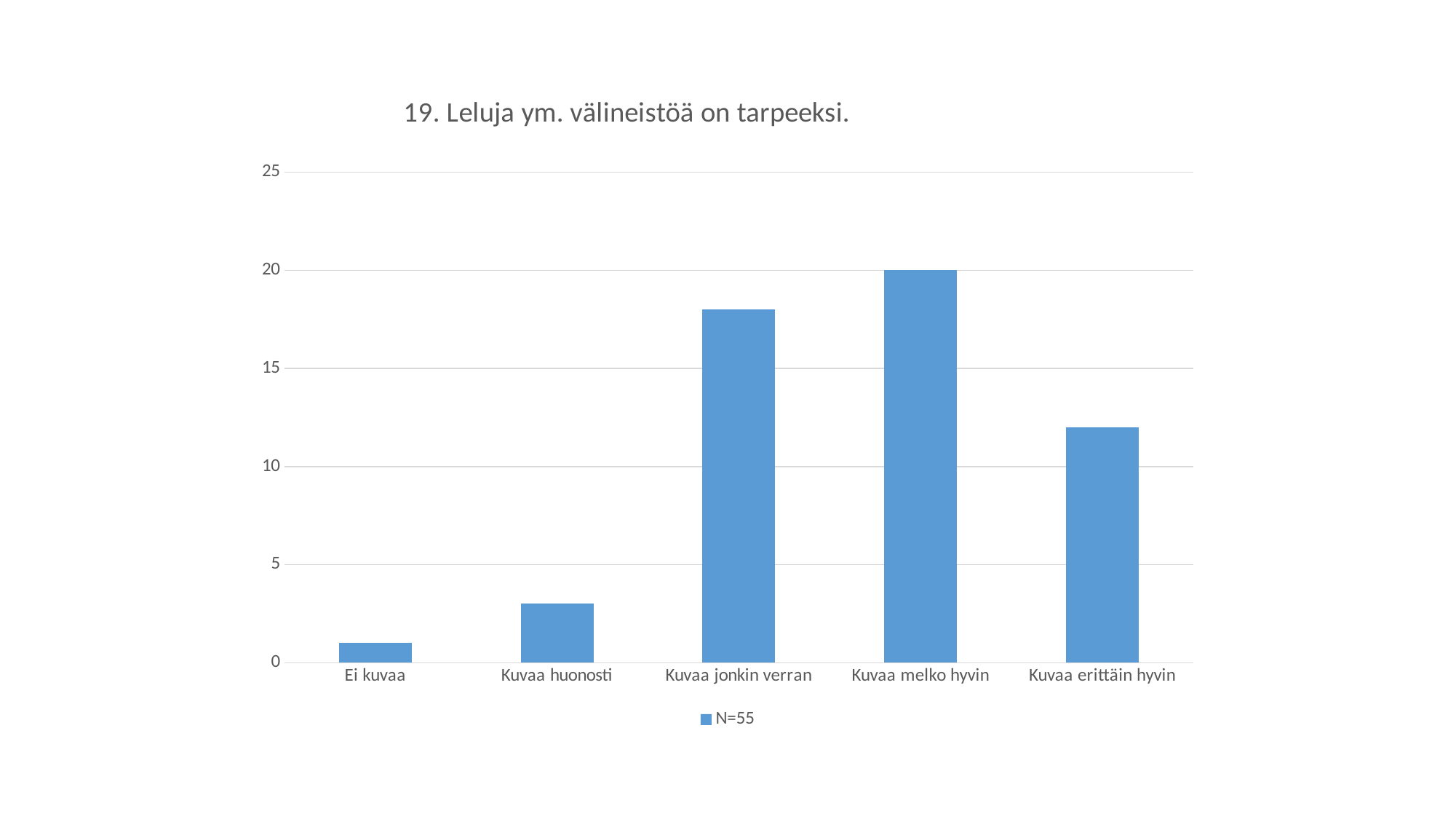
What is the value for Kuvaa melko hyvin? 20 What kind of chart is shown on the slide? bar chart Which is larger, the value for Kuvaa jonkin verran or the value for Kuvaa erittäin hyvin? Kuvaa jonkin verran How many categories are shown on the x axis? 5 How many series does the legend list? 1 Which category has the lowest value? Ei kuvaa Is the value for Kuvaa jonkin verran greater or less than 15? greater What is the title of the chart? 19. Leluja ym. välineistöä on tarpeeksi. Which category has the highest value? Kuvaa melko hyvin Is the value for Kuvaa huonosti greater or less than 5? less Which is larger, the value for Kuvaa huonosti or the value for Ei kuvaa? Kuvaa huonosti Is the value for Kuvaa erittäin hyvin greater or less than 15? less